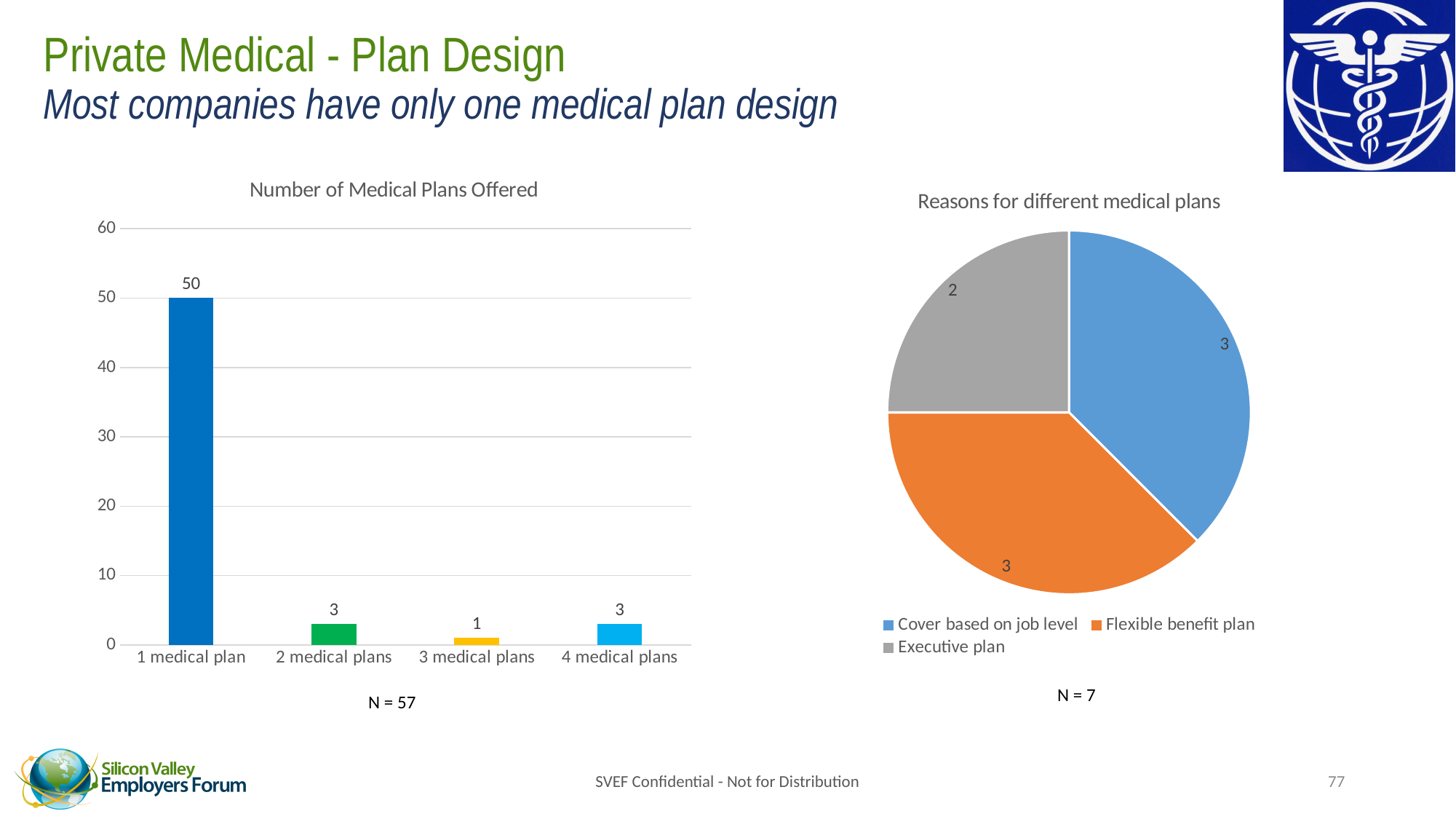
In the 'Number of Medical Plans Offered' chart, how many categories are shown on the x axis? 4 In the 'Number of Medical Plans Offered' chart, what is the value for 3 medical plans? 1 In the 'Number of Medical Plans Offered' chart, what is the value for 1 medical plan? 50 What kind of chart is 'Number of Medical Plans Offered'? Bar chart In the 'Reasons for different medical plans' chart, what is the value for Executive plan? 2 In the 'Reasons for different medical plans' chart, which colour represents Flexible benefit plan? Orange In the 'Reasons for different medical plans' chart, what is the value for Flexible benefit plan? 3 What kind of chart is 'Reasons for different medical plans'? Pie chart In the 'Number of Medical Plans Offered' chart, which category has the lowest value? 3 medical plans In the 'Number of Medical Plans Offered' chart, what is the difference between the values for 1 medical plan and 2 medical plans? 47 In the 'Reasons for different medical plans' chart, how many entries does the legend list? 3 In the 'Number of Medical Plans Offered' chart, which category has the highest value? 1 medical plan